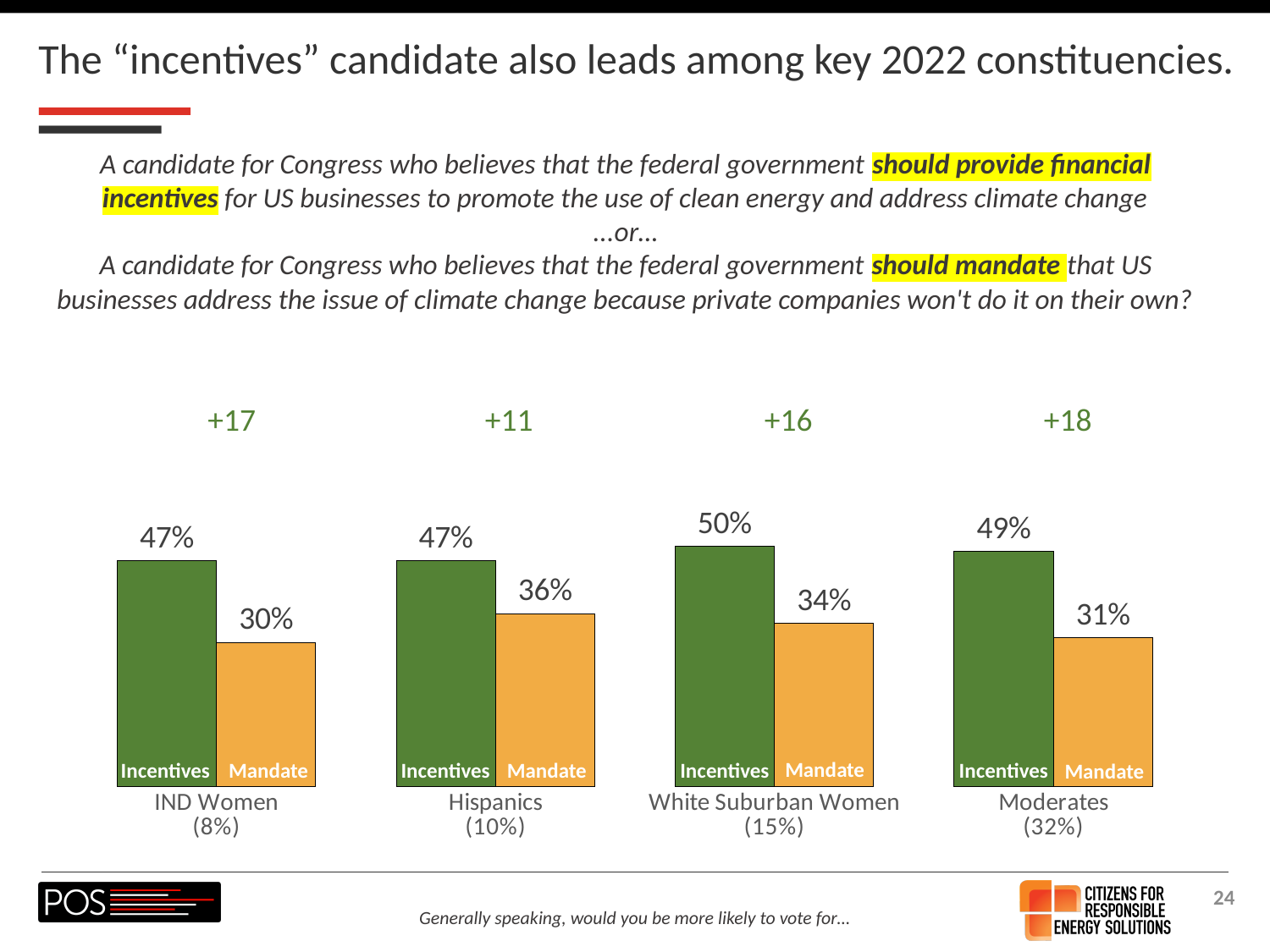
What colour is the Mandate bar in each chart? Orange What type of chart is used for the Hispanics group? Bar chart In the Hispanics chart, which bar is taller, Incentives or Mandate? Incentives In the Moderates chart, what percentage is shown for Mandate? 31% In the IND Women chart, what is the difference between the Incentives and Mandate values? 17 In the Hispanics chart, what percentage is shown for Mandate? 36% In the IND Women chart, what percentage is shown for Incentives? 47% In the White Suburban Women chart, what percentage is shown for Incentives? 50% How many bars are in the Moderates chart? 2 In the White Suburban Women chart, what is the difference between the Incentives and Mandate values? 16 Across the four charts, which group shows the lowest Mandate value? IND Women Across the four charts, which group shows the highest Incentives value? White Suburban Women